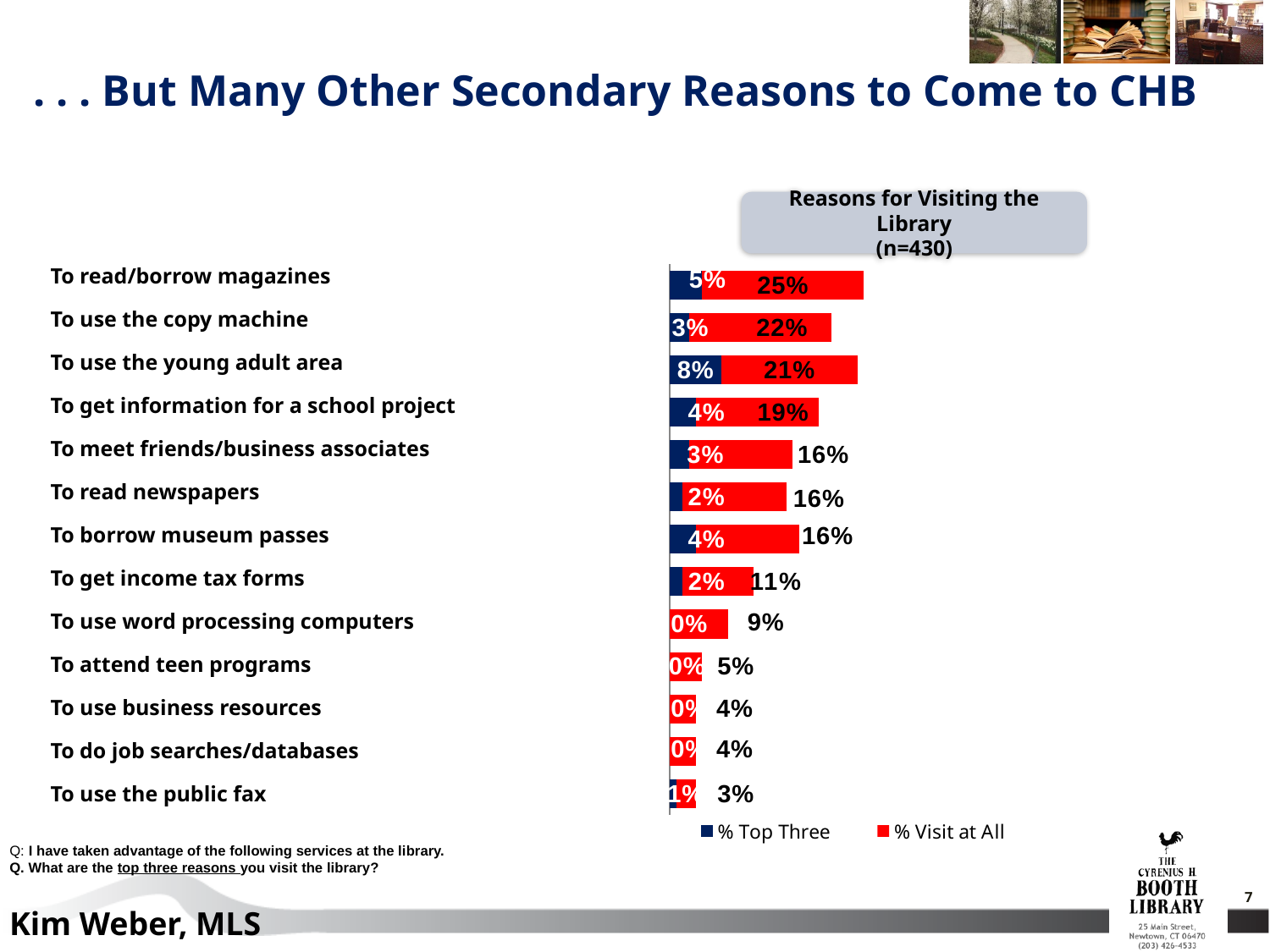
Which has a larger % Visit at All value: "To use word processing computers" or "To attend teen programs"? To use word processing computers What is the % Visit at All value for "To get income tax forms"? 11% Which category has the highest % Visit at All value? To read/borrow magazines What is the % Top Three value for "To use the young adult area"? 8% What is the % Visit at All value for "To read/borrow magazines"? 25% How many categories are shown in the chart? 13 Which category has the lowest % Visit at All value? To use the public fax What is the title of the chart? Reasons for Visiting the Library (n=430) What is the difference between the % Visit at All values for "To use the copy machine" and "To get information for a school project"? 3% Which category has the highest % Top Three value? To use the young adult area What kind of chart is shown on the slide? Bar chart How many series does the legend list? 2